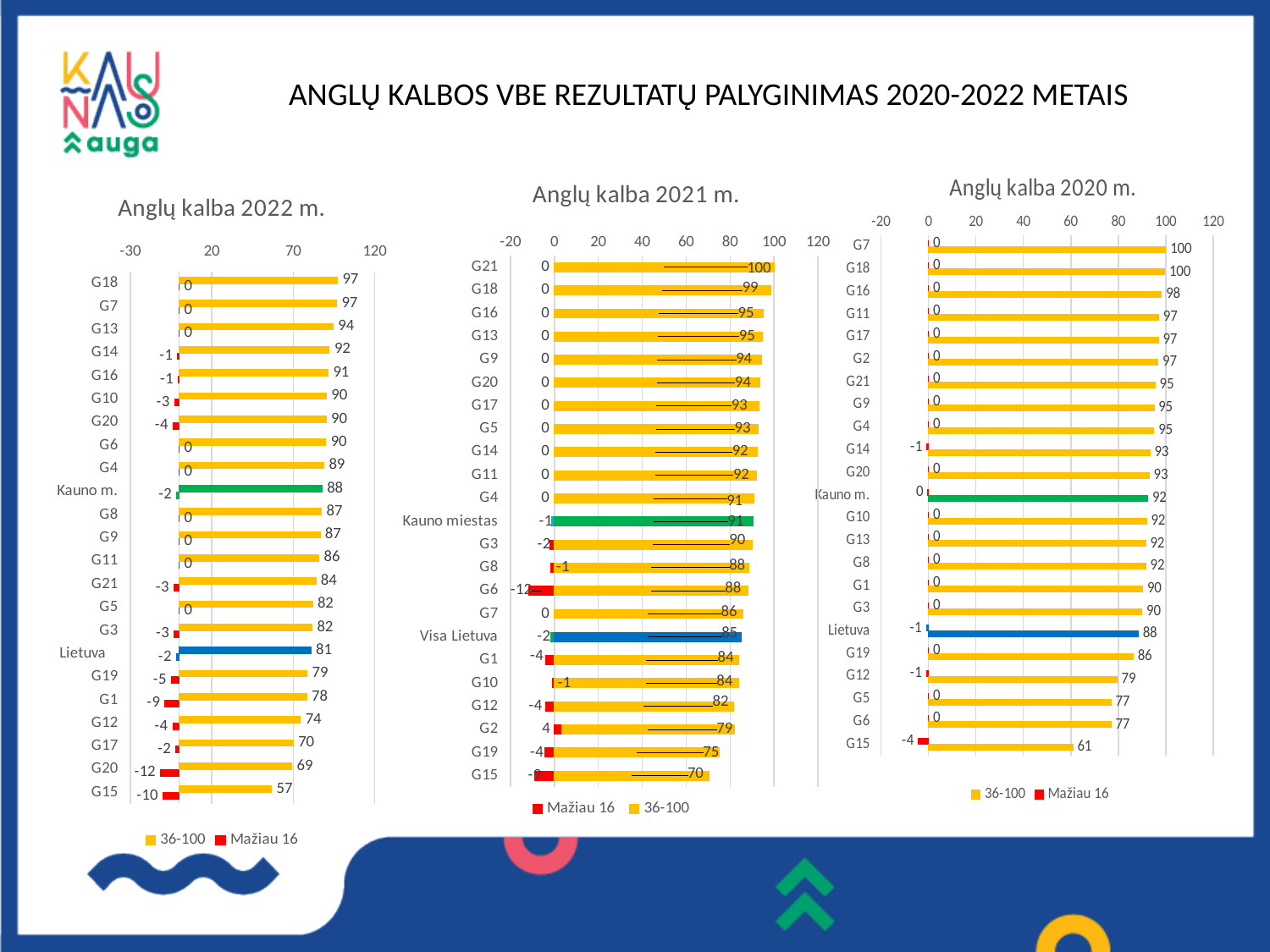
In the 'Anglų kalba 2022 m.' chart, what is the difference between the 36-100 values for G18 and Lietuva? 16 In the 'Anglų kalba 2022 m.' chart, what is the 36-100 value for Kauno m.? 88 In the 'Anglų kalba 2022 m.' chart, what is the Mažiau 16 value for G15? -10 In the 'Anglų kalba 2021 m.' chart, what is the Mažiau 16 value for G6? -12 What type of chart is 'Anglų kalba 2022 m.'? Bar chart In the 'Anglų kalba 2020 m.' chart, what is the difference between the 36-100 values for G7 and G15? 39 How many series does the legend of the 'Anglų kalba 2020 m.' chart list? 2 In the 'Anglų kalba 2020 m.' chart, what is the 36-100 value for Lietuva? 88 In the 'Anglų kalba 2021 m.' chart, which has the larger 36-100 value, Kauno miestas or Visa Lietuva? Kauno miestas In the 'Anglų kalba 2020 m.' chart, which category has the lowest 36-100 value? G15 In the 'Anglų kalba 2022 m.' chart, which category has the lowest 36-100 value? G15 In the 'Anglų kalba 2021 m.' chart, what is the 36-100 value for G21? 100